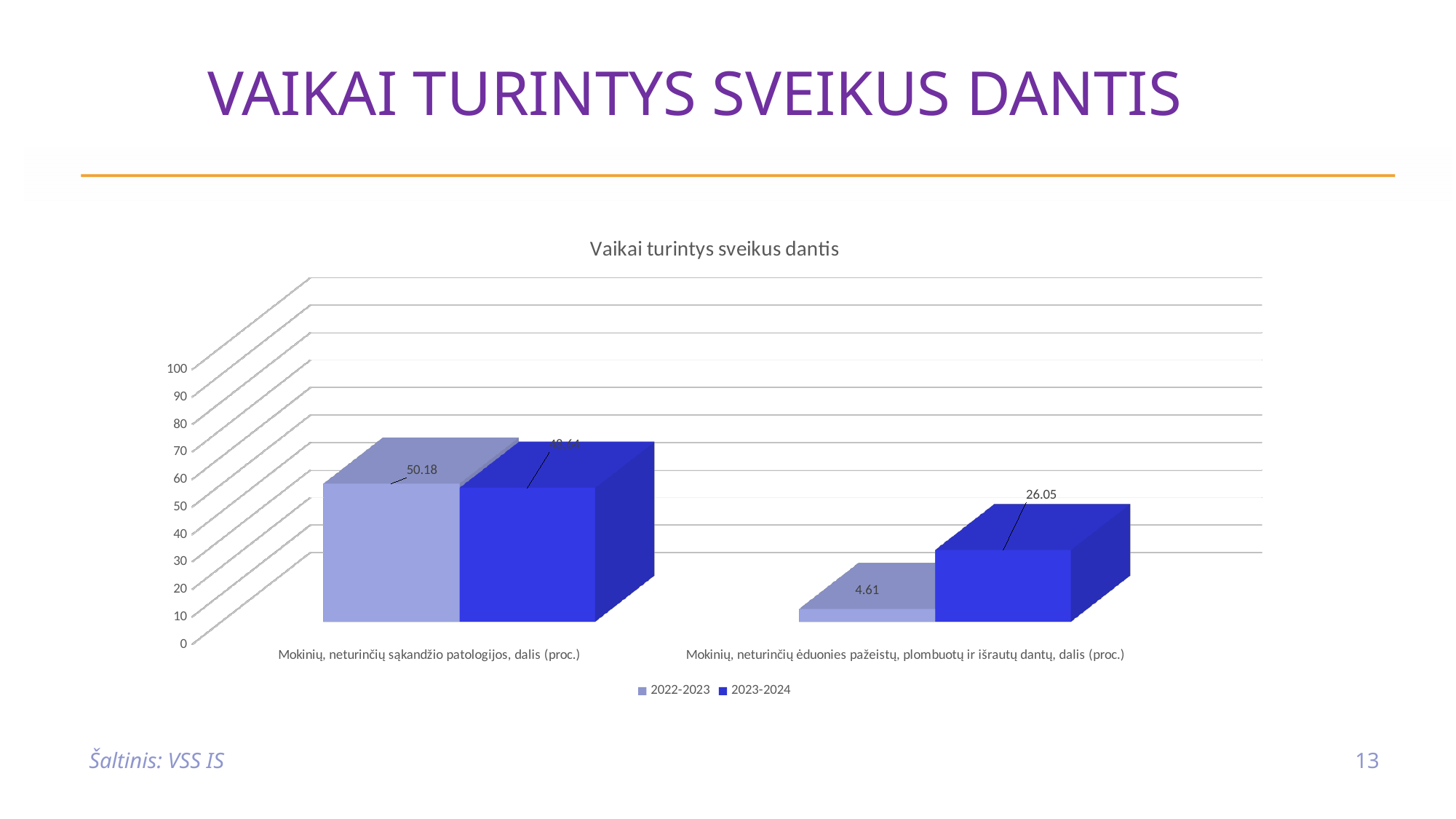
How many categories are shown on the x axis? 2 What is the 2022-2023 value for 'Mokinių, neturinčių ėduonies pažeistų, plombuotų ir išrautų dantų, dalis (proc.)'? 4.61 Is the 2023-2024 value for 'Mokinių, neturinčių sąkandžio patologijos, dalis (proc.)' greater or less than 30? greater What is the 2022-2023 value for 'Mokinių, neturinčių sąkandžio patologijos, dalis (proc.)'? 50.18 For 'Mokinių, neturinčių ėduonies pažeistų, plombuotų ir išrautų dantų, dalis (proc.)', which series has the larger value, 2022-2023 or 2023-2024? 2023-2024 How many series does the legend list? 2 What is the title of the chart? Vaikai turintys sveikus dantis What type of chart is shown on the slide? bar chart What is the 2023-2024 value for 'Mokinių, neturinčių ėduonies pažeistų, plombuotų ir išrautų dantų, dalis (proc.)'? 26.05 What is the difference between the 2022-2023 values of the two categories? 45.57 Which series has the lowest value in the chart? 2022-2023 What is the difference between the 2023-2024 and 2022-2023 values for 'Mokinių, neturinčių ėduonies pažeistų, plombuotų ir išrautų dantų, dalis (proc.)'? 21.44